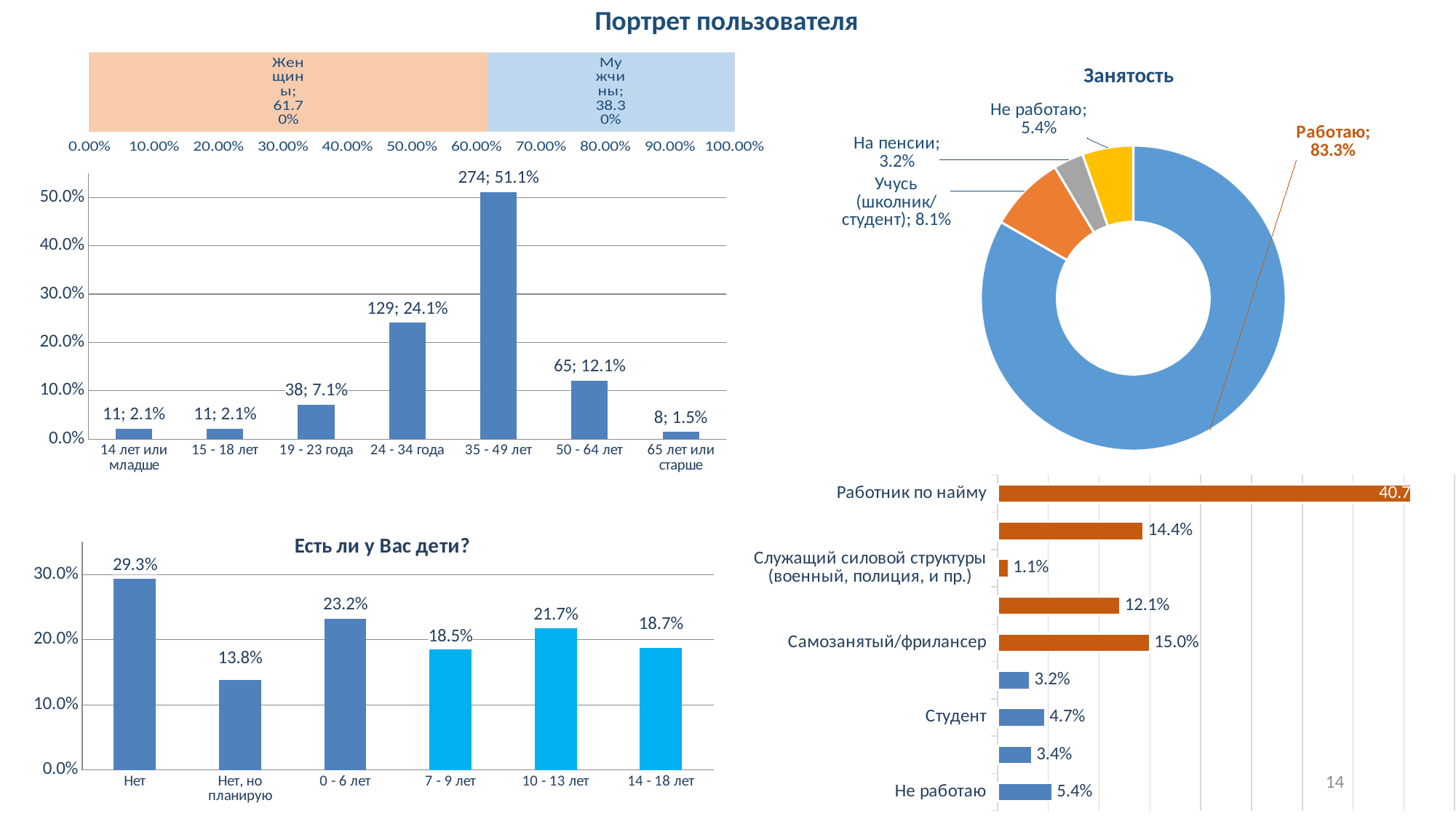
In the gender bar at the top left, what is the value for Женщины? 61.70% In the age bar chart on the left, how many age categories are shown? 7 In the age bar chart on the left, which is larger: 24 - 34 года or 50 - 64 лет? 24 - 34 года What type of chart is the 'Занятость' chart? Doughnut (pie) chart In the chart 'Есть ли у Вас дети?', what is the value for 'Нет, но планирую'? 13.8% In the chart 'Есть ли у Вас дети?', which category has the highest value? Нет In the age bar chart on the left, what is the data label for the 35 - 49 лет bar? 274; 51.1% In the 'Занятость' chart, what share is labelled for 'Учусь (школьник/студент)'? 8.1% In the chart 'Есть ли у Вас дети?', what is the difference between the values for 'Нет' and '0 - 6 лет'? 6.1 percentage points In the age bar chart on the left, which age group has the lowest value? 65 лет или старше In the horizontal bar chart at the bottom right, what is the value for 'Самозанятый/фрилансер'? 15.0% In the horizontal bar chart at the bottom right, which labelled category has the lowest value? Служащий силовой структуры (военный, полиция, и пр.)